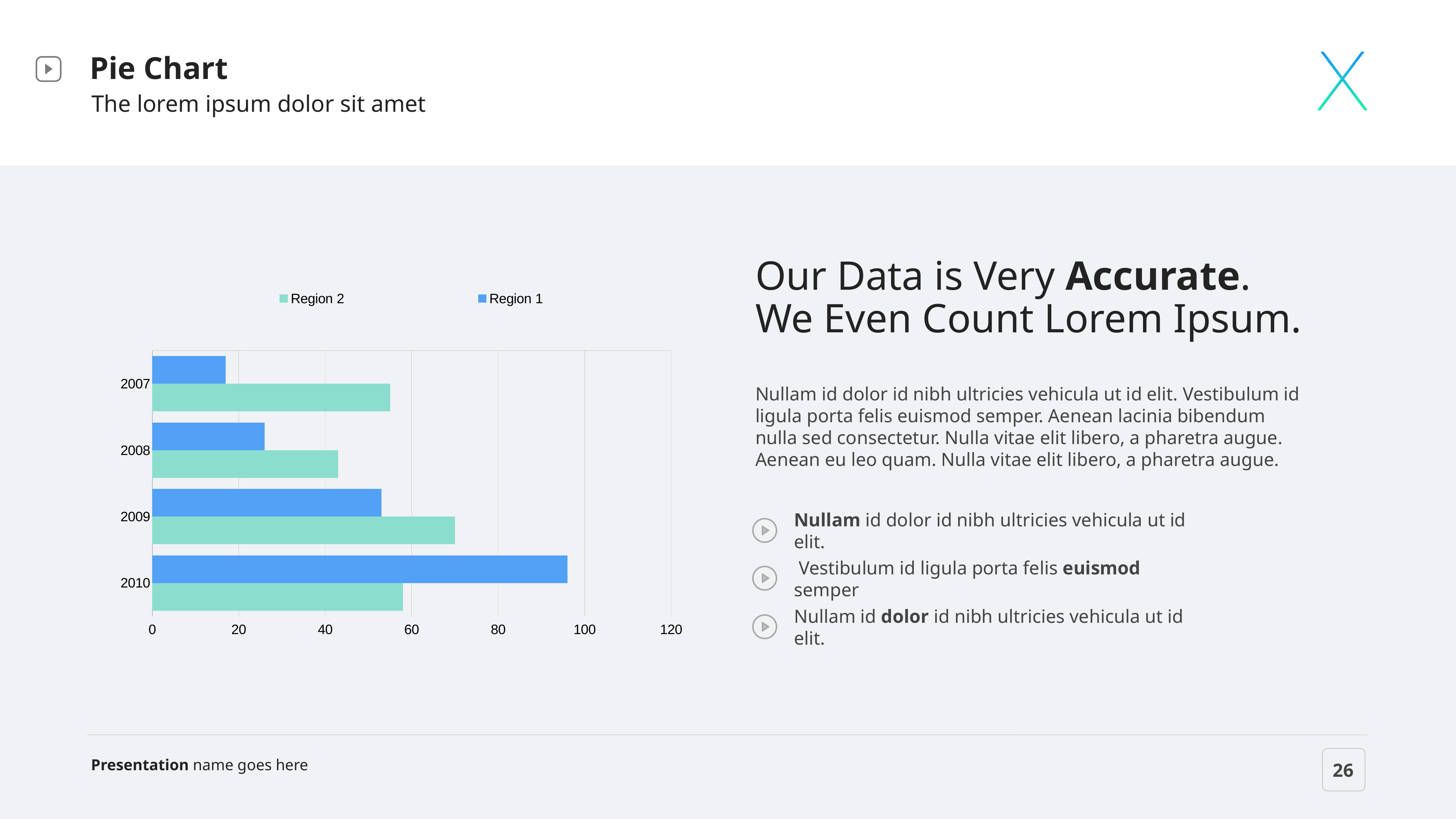
Is the value for Region 2 in 2009 greater or less than 60? greater In 2010, which series has the larger value, Region 1 or Region 2? Region 1 Do the Region 1 values rise or fall from 2007 to 2010? rise In 2007, which series has the larger value, Region 1 or Region 2? Region 2 How many years are shown on the chart's category axis? 4 Is the value for Region 1 in 2010 greater or less than 80? greater Which year has the highest value for Region 1? 2010 How many series does the chart's legend list? 2 Which year has the lowest value for Region 1? 2007 What kind of chart is shown on the slide? bar chart Which year has the highest value for Region 2? 2009 Which year has the lowest value for Region 2? 2008